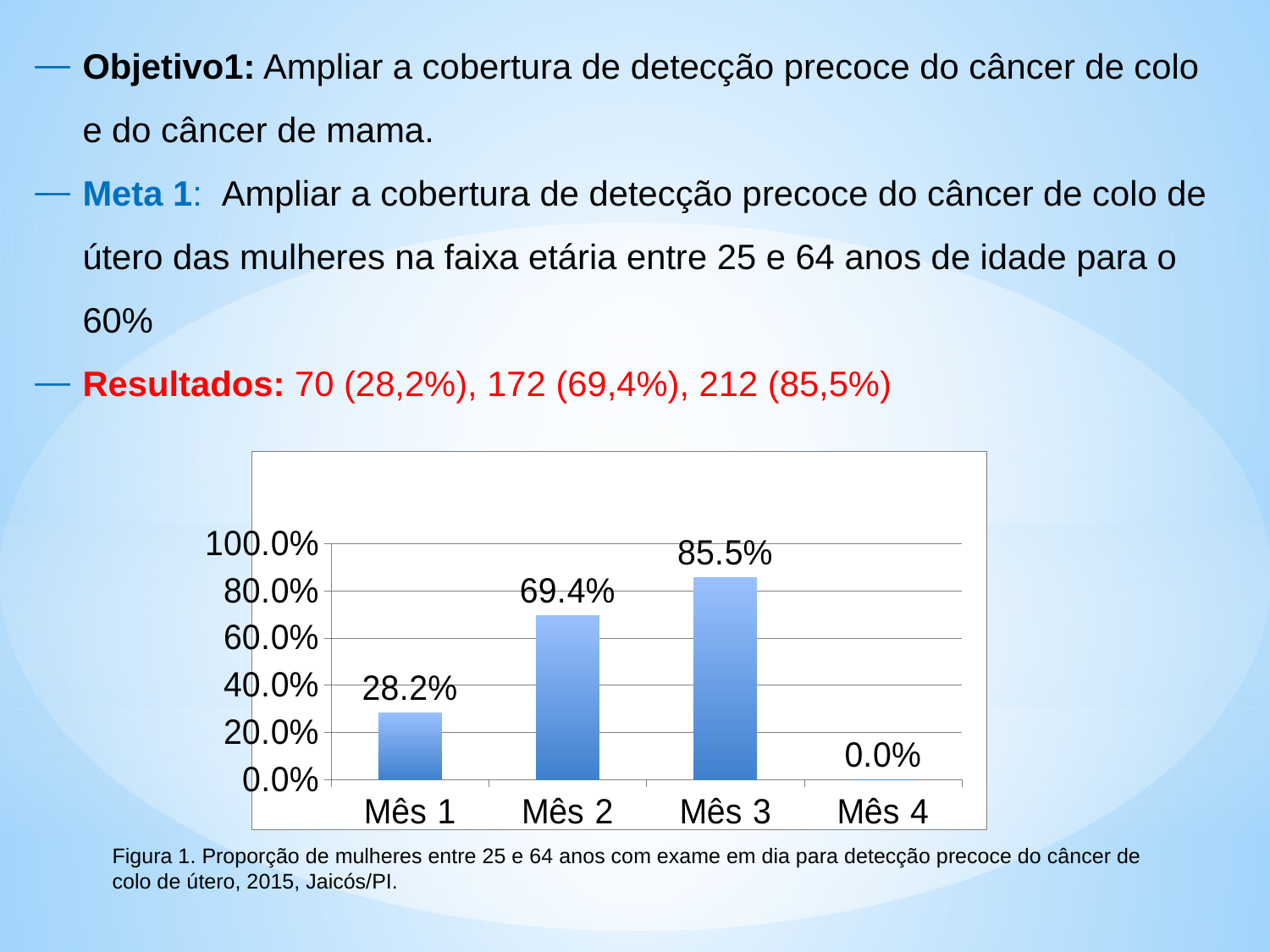
What is the value for Mês 3? 85.5% What is the difference between the values for Mês 2 and Mês 1? 41.2% What kind of chart is shown? bar chart What is the difference between the values for Mês 3 and Mês 2? 16.1% Do the values rise or fall from Mês 1 to Mês 3? rise Which month has the highest value? Mês 3 Which is larger, the value for Mês 1 or the value for Mês 2? Mês 2 Which month has the lowest value? Mês 4 What is the value for Mês 1? 28.2% What is the value for Mês 2? 69.4% What is the value for Mês 4? 0.0% How many categories are shown on the x axis? 4